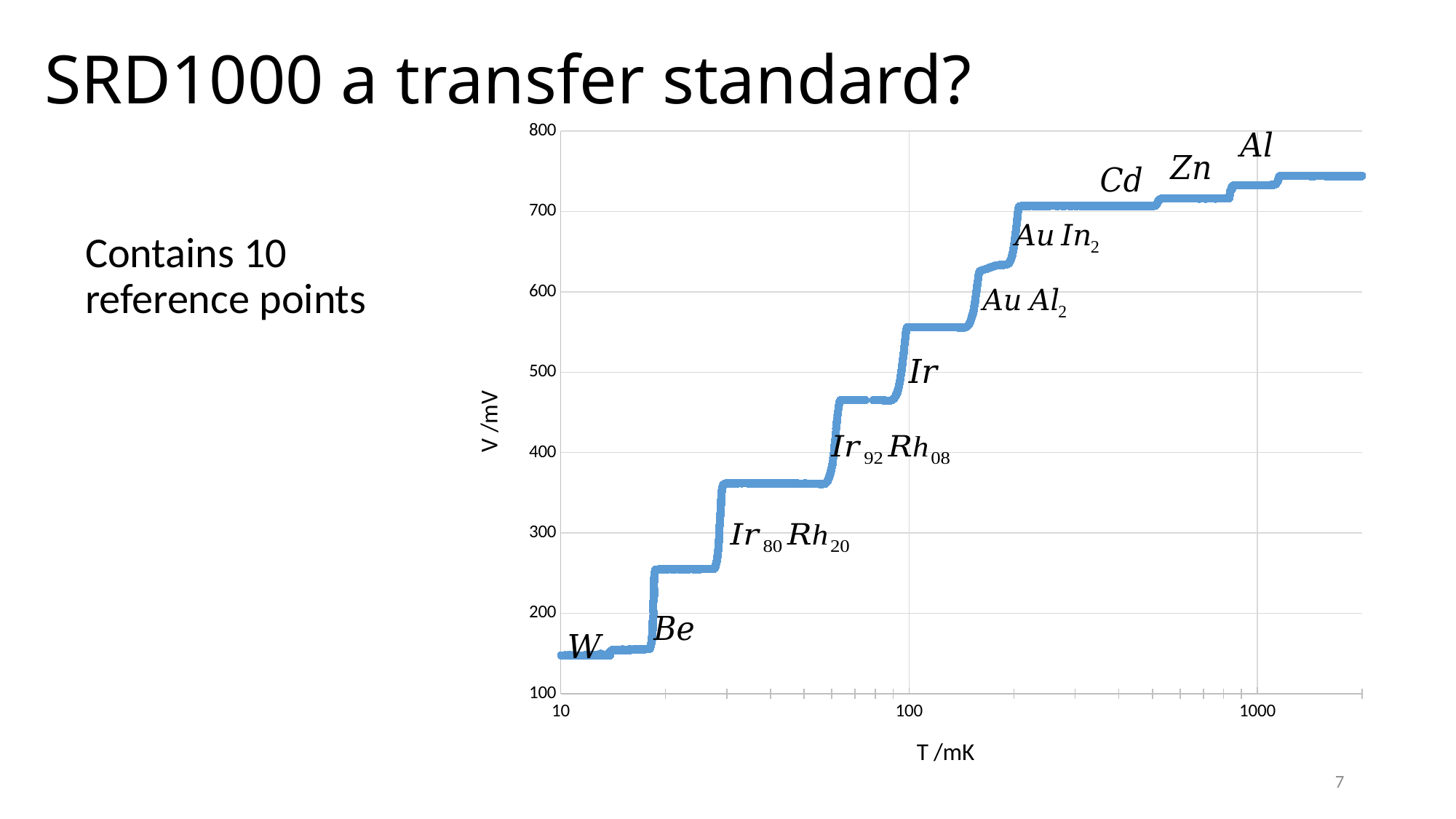
Is the voltage plateau just above the AuAl2 step greater or less than 500 mV? greater Is the voltage plateau just above the Ir step greater or less than 500 mV? greater What is the label of the vertical axis? V /mV Is the voltage at the highest temperature shown greater or less than 800 mV? less What is the label of the horizontal axis? T /mK How many reference points does the slide say the SRD1000 contains? 10 Which reference point is labelled at the highest voltage on the curve? Al What kind of chart is shown on the slide? line chart Does the voltage V rise or fall as the temperature T increases along the x axis? rise